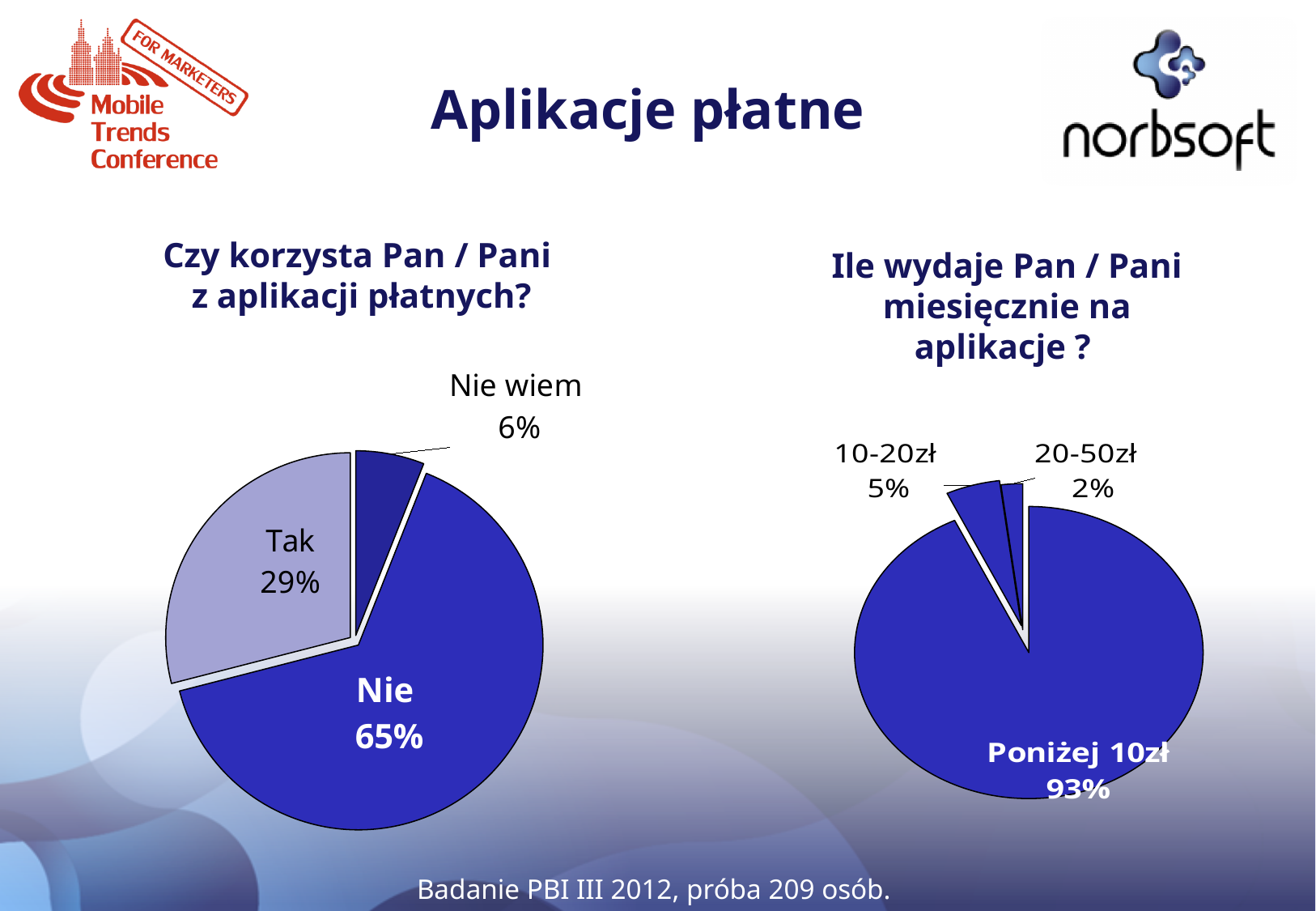
In the right pie chart (Ile wydaje Pan / Pani miesięcznie na aplikacje?), which is larger: "10-20zł" or "20-50zł"? 10-20zł In the left pie chart (Czy korzysta Pan / Pani z aplikacji płatnych?), what is the difference in percentage points between "Nie" and "Tak"? 36 percentage points In the right pie chart (Ile wydaje Pan / Pani miesięcznie na aplikacje?), which slice is the smallest? 20-50zł In the left pie chart (Czy korzysta Pan / Pani z aplikacji płatnych?), how many slices are there? 3 In the right pie chart (Ile wydaje Pan / Pani miesięcznie na aplikacje?), what share is labelled for "10-20zł"? 5% In the left pie chart (Czy korzysta Pan / Pani z aplikacji płatnych?), what share is labelled for "Nie"? 65% In the right pie chart (Ile wydaje Pan / Pani miesięcznie na aplikacje?), what share is labelled for "Poniżej 10zł"? 93% In the left pie chart (Czy korzysta Pan / Pani z aplikacji płatnych?), what share is labelled for "Nie wiem"? 6% In the left pie chart (Czy korzysta Pan / Pani z aplikacji płatnych?), what share is labelled for "Tak"? 29% In the left pie chart (Czy korzysta Pan / Pani z aplikacji płatnych?), which slice is the smallest? Nie wiem In the left pie chart (Czy korzysta Pan / Pani z aplikacji płatnych?), which slice is the largest? Nie What kind of chart is used on the right side of the slide (Ile wydaje Pan / Pani miesięcznie na aplikacje?)? Pie chart